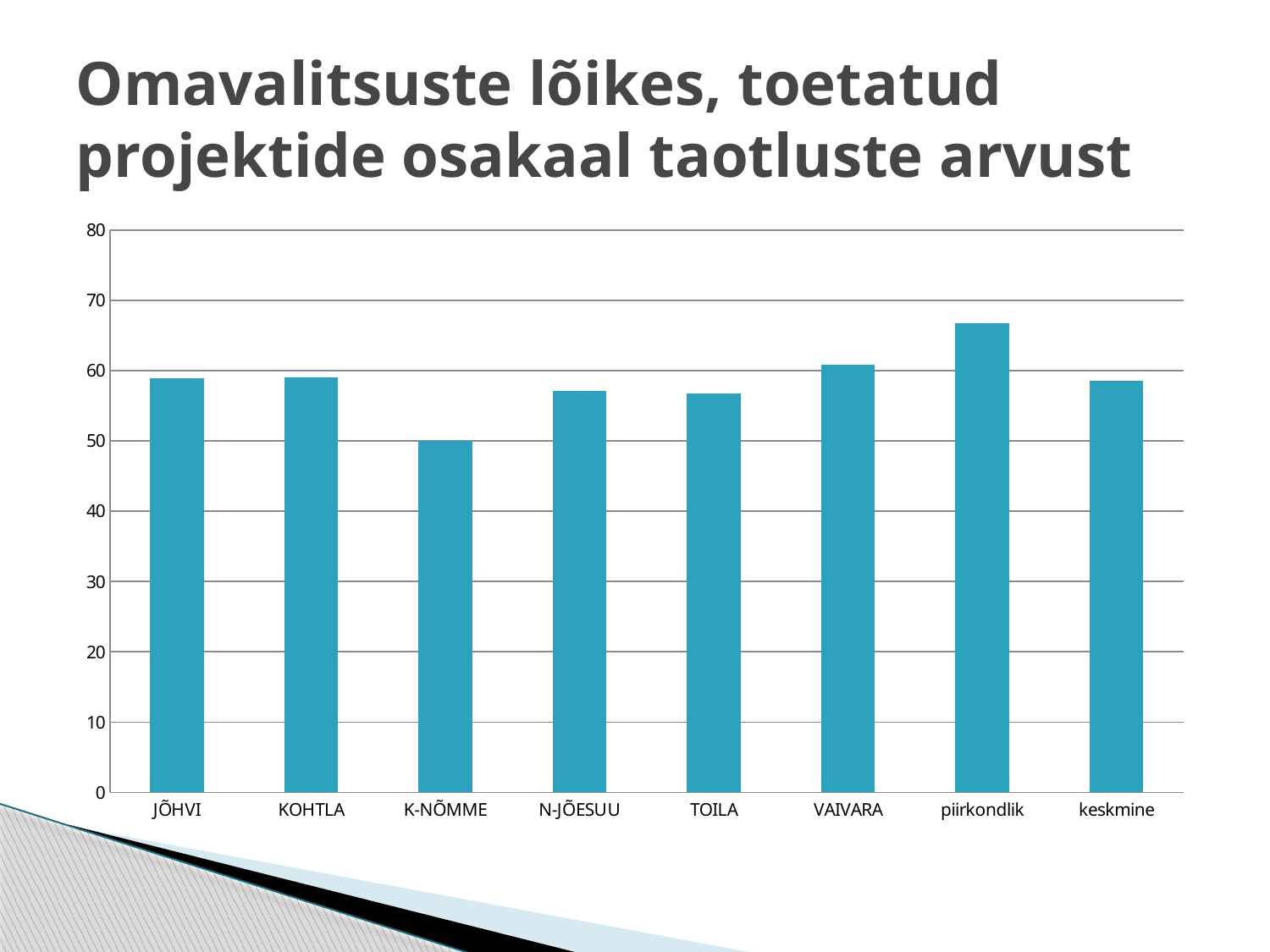
Which is larger, the value for piirkondlik or the value for VAIVARA? piirkondlik Which category has the lowest bar in the chart? K-NÕMME What is the title of the slide containing the chart? Omavalitsuste lõikes, toetatud projektide osakaal taotluste arvust Is the value for TOILA greater or less than 60? less Is the value for K-NÕMME greater or less than 60? less Which category has the highest bar in the chart? piirkondlik Is the value for keskmine greater or less than 50? greater Which is larger, the value for VAIVARA or the value for TOILA? VAIVARA What kind of chart is shown on the slide? bar chart How many categories are shown on the x axis of the chart? 8 What is the highest value shown on the y axis of the chart? 80